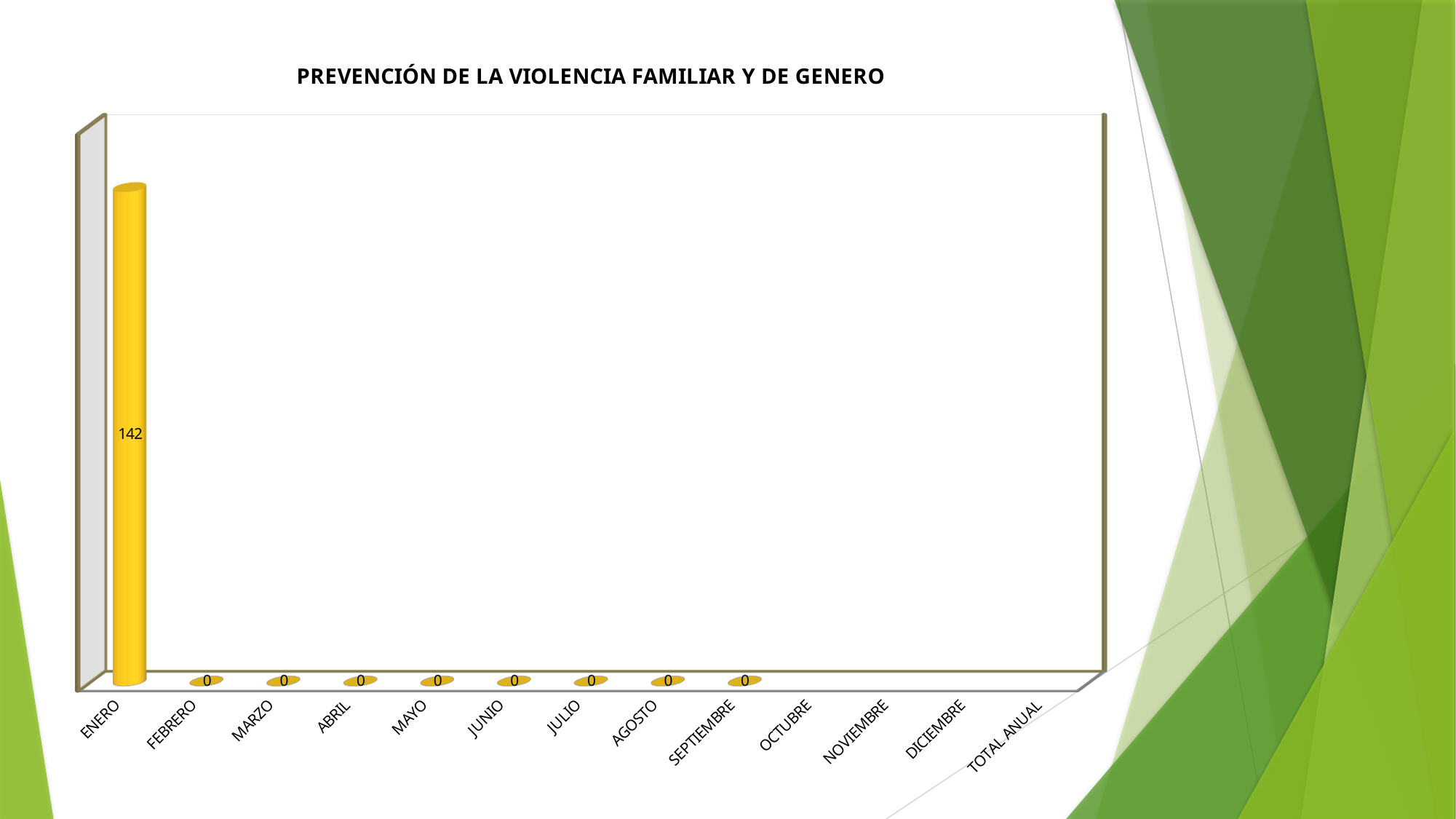
Which is larger, the value for ENERO or the value for JULIO? ENERO What kind of chart is this? bar chart What is the difference between the values for ENERO and MARZO? 142 What is the value for ENERO? 142 What is the title of the chart? PREVENCIÓN DE LA VIOLENCIA FAMILIAR Y DE GENERO What is the value for SEPTIEMBRE? 0 How many categories are shown on the x axis? 13 What colour are the bars in the chart? yellow Which category has the highest value? ENERO Do the values rise or fall from ENERO to FEBRERO? fall What is the value for FEBRERO? 0 How many categories have a data label of 0? 8